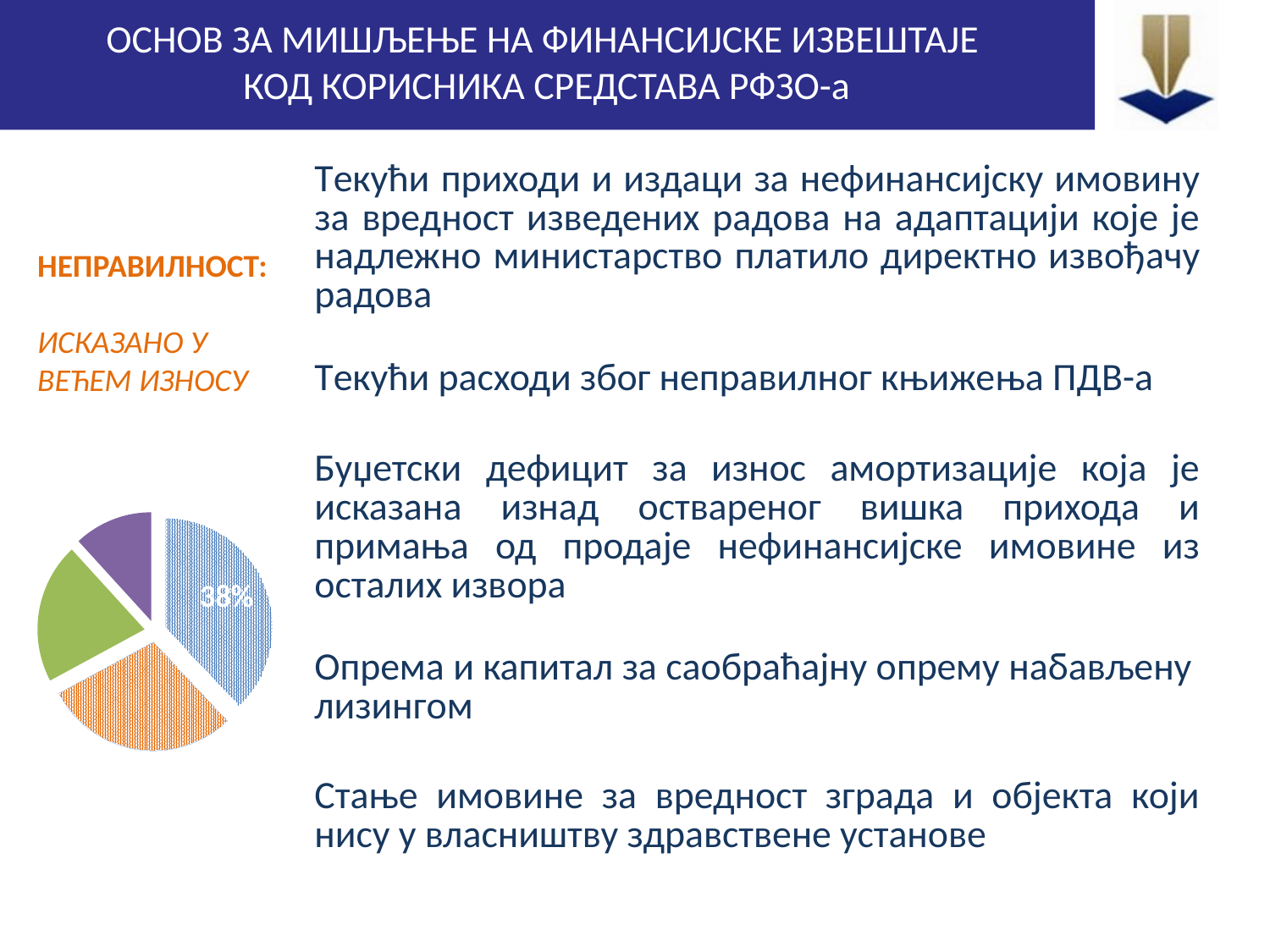
Which is larger in the pie chart, the orange slice or the purple slice? the orange slice Which slice of the pie chart is the largest? the blue slice How many slices of the pie chart have a printed data label? 1 Which is larger in the pie chart, the blue slice or the green slice? the blue slice How many slices does the pie chart have? 4 What kind of chart is shown on the slide? pie chart Which slice of the pie chart is the smallest? the purple slice Which slice of the pie chart carries the data label 38%? the blue slice What percentage is printed on the blue slice of the pie chart? 38% Does the pie chart show a legend? no